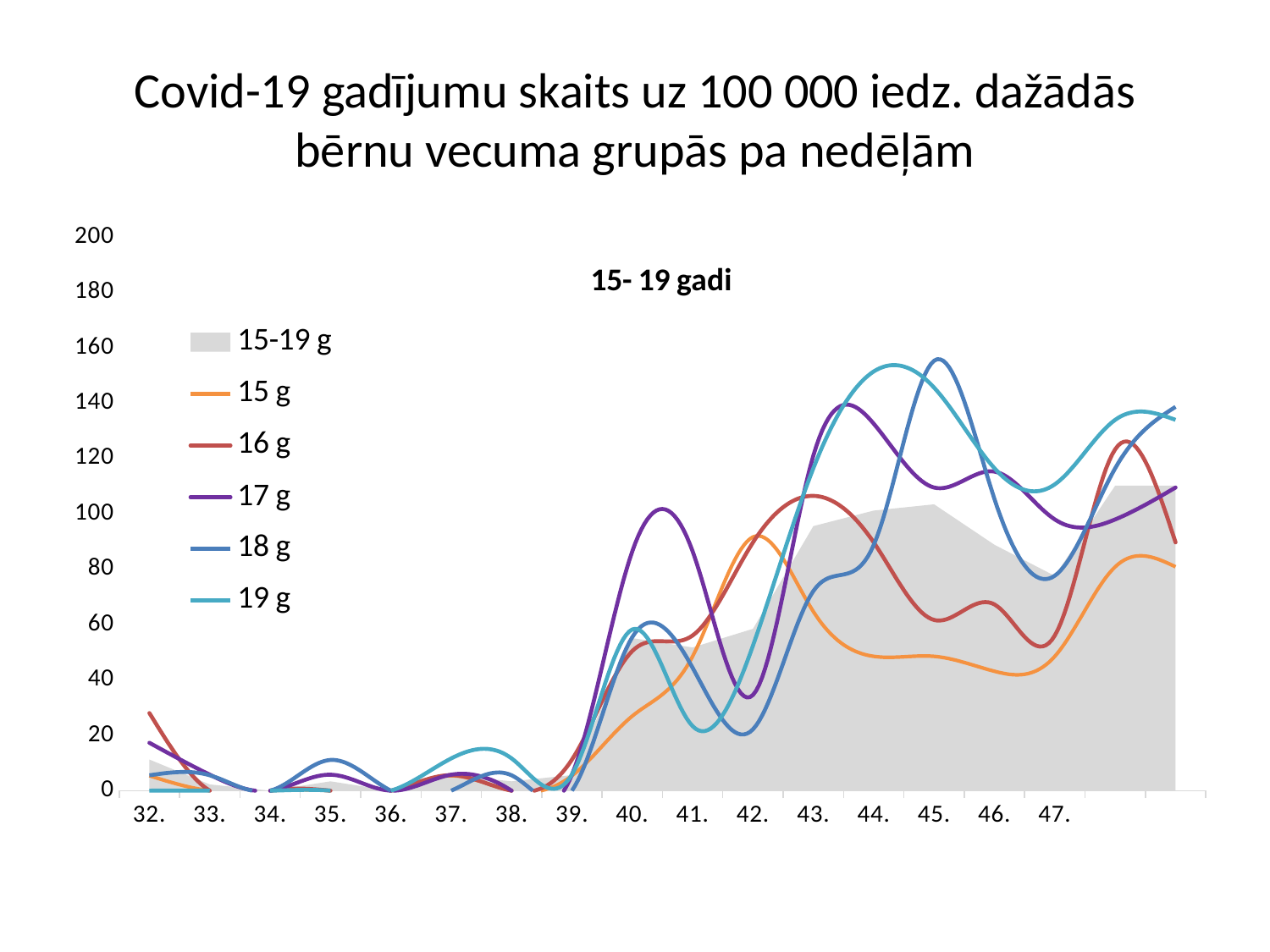
Which series is shown as a shaded grey area rather than a line? 15-19 g Is the value for 18 g at week 45 greater or less than 140? greater Is the value for 15-19 g at week 42 greater or less than 40? greater Is the value for 19 g at week 44 greater or less than 140? greater At week 47, which is larger: the value for 19 g or the value for 16 g? 19 g What kind of chart is shown on the slide? combination area and line chart Do the values for 19 g rise or fall from week 39 to week 44? rise At week 45, which is larger: the value for 18 g or the value for 15 g? 18 g What is the title printed inside the chart area? 15- 19 gadi How many series does the legend list? 6